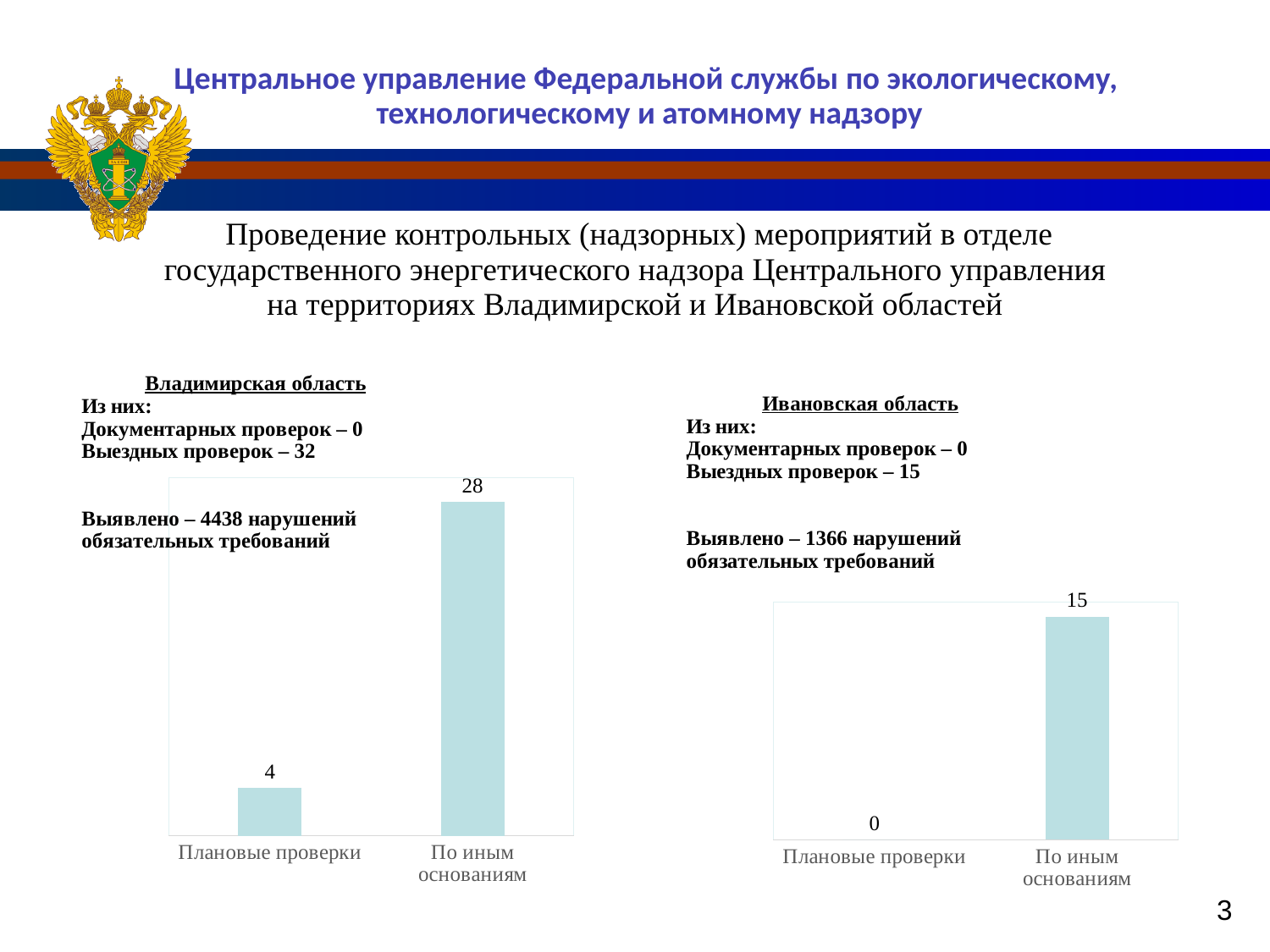
In the right chart (Ивановская область), which category has the lowest value? Плановые проверки In the right chart (Ивановская область), what is the value for Плановые проверки? 0 In the right chart (Ивановская область), what is the difference between По иным основаниям and Плановые проверки? 15 How many charts are on the slide? 2 In the left chart (Владимирская область), which category has the highest value? По иным основаниям Which is larger: По иным основаниям in the left chart (Владимирская область) or По иным основаниям in the right chart (Ивановская область)? Left chart (Владимирская область) In the left chart (Владимирская область), what is the value for Плановые проверки? 4 What type of chart is the right chart (Ивановская область)? Bar chart In the left chart (Владимирская область), what is the difference between По иным основаниям and Плановые проверки? 24 In the right chart (Ивановская область), what is the value for По иным основаниям? 15 In the left chart (Владимирская область), what is the value for По иным основаниям? 28 How many categories are shown in the left chart (Владимирская область)? 2